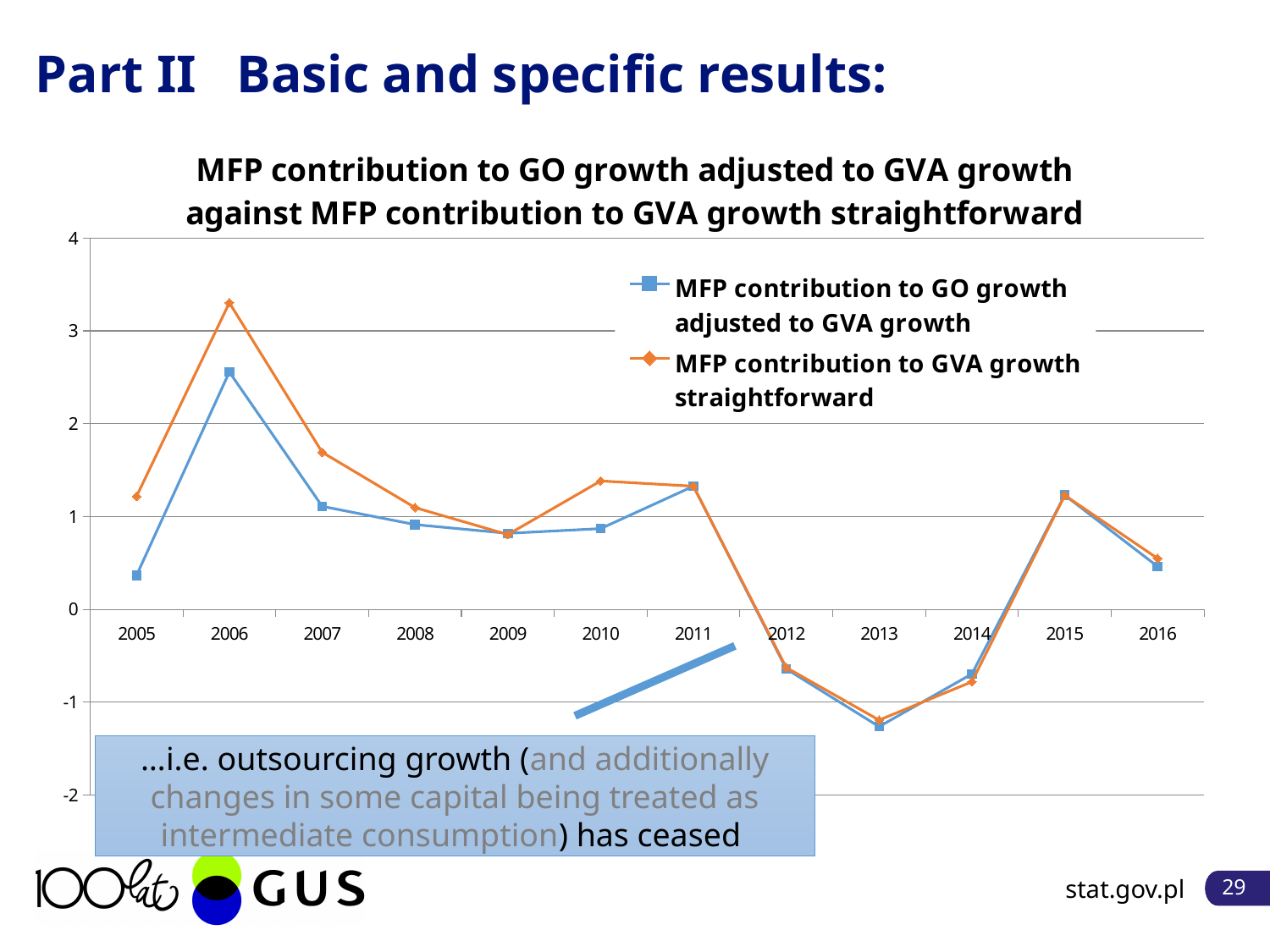
In which year does the 'MFP contribution to GVA growth straightforward' series reach its highest value? 2006 In which year does the 'MFP contribution to GO growth adjusted to GVA growth' series reach its highest value? 2006 How many years are plotted along the x axis? 12 Between 2006 and 2009, does the 'MFP contribution to GVA growth straightforward' series rise or fall? fall Is the 2005 value for 'MFP contribution to GO growth adjusted to GVA growth' greater or less than 1? less In which year does the 'MFP contribution to GVA growth straightforward' series reach its lowest value? 2013 Is the 2006 value for 'MFP contribution to GVA growth straightforward' greater or less than 3? greater Is the 2013 value for 'MFP contribution to GO growth adjusted to GVA growth' greater or less than -1? less What is the first line of the chart's title? MFP contribution to GO growth adjusted to GVA growth How many series does the legend list? 2 In 2006, which series has the larger value: 'MFP contribution to GO growth adjusted to GVA growth' or 'MFP contribution to GVA growth straightforward'? MFP contribution to GVA growth straightforward What kind of chart is shown on the slide? line chart